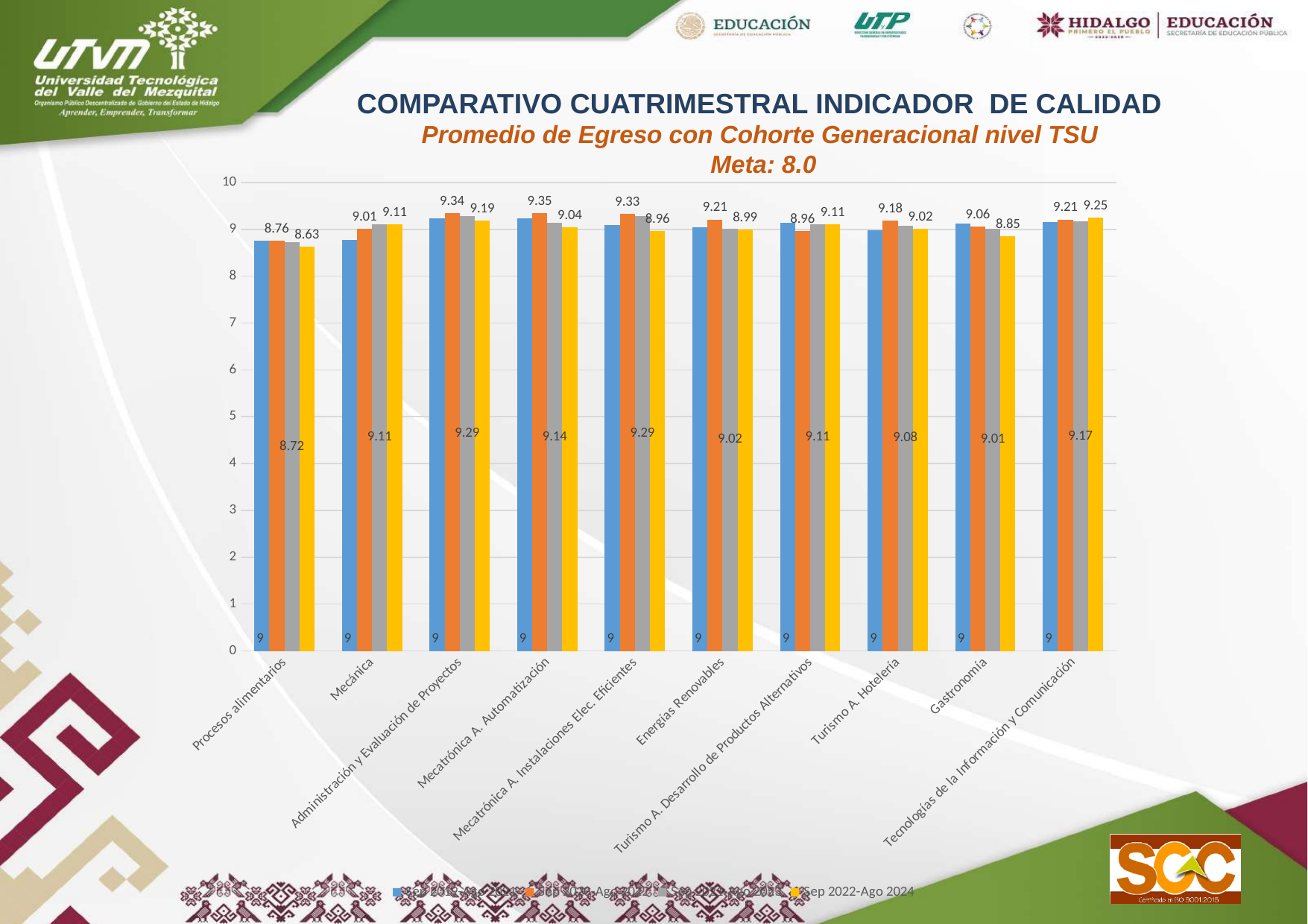
In the yellow (Sep 2022-Ago 2024) series, which is larger: Gastronomía or Mecánica? Mecánica What kind of chart is shown on the slide? bar chart What is the value of the yellow (Sep 2022-Ago 2024) bar for Procesos alimentarios? 8.63 What target (Meta) is stated in the chart's title? 8.0 Is the value of the yellow bar for Gastronomía greater or less than 8? greater What is the value of the yellow (Sep 2022-Ago 2024) bar for Tecnologías de la Información y Comunicación? 9.25 Which program has the lowest value in the yellow (Sep 2022-Ago 2024) series? Procesos alimentarios How many series does the chart's legend list? 4 What is the difference between the yellow (Sep 2022-Ago 2024) values for Tecnologías de la Información y Comunicación and Procesos alimentarios? 0.62 Which program has the highest value in the yellow (Sep 2022-Ago 2024) series? Tecnologías de la Información y Comunicación What is the value labelled inside the gray bar for Administración y Evaluación de Proyectos? 9.29 How many programs (categories) are shown along the x axis of the chart? 10